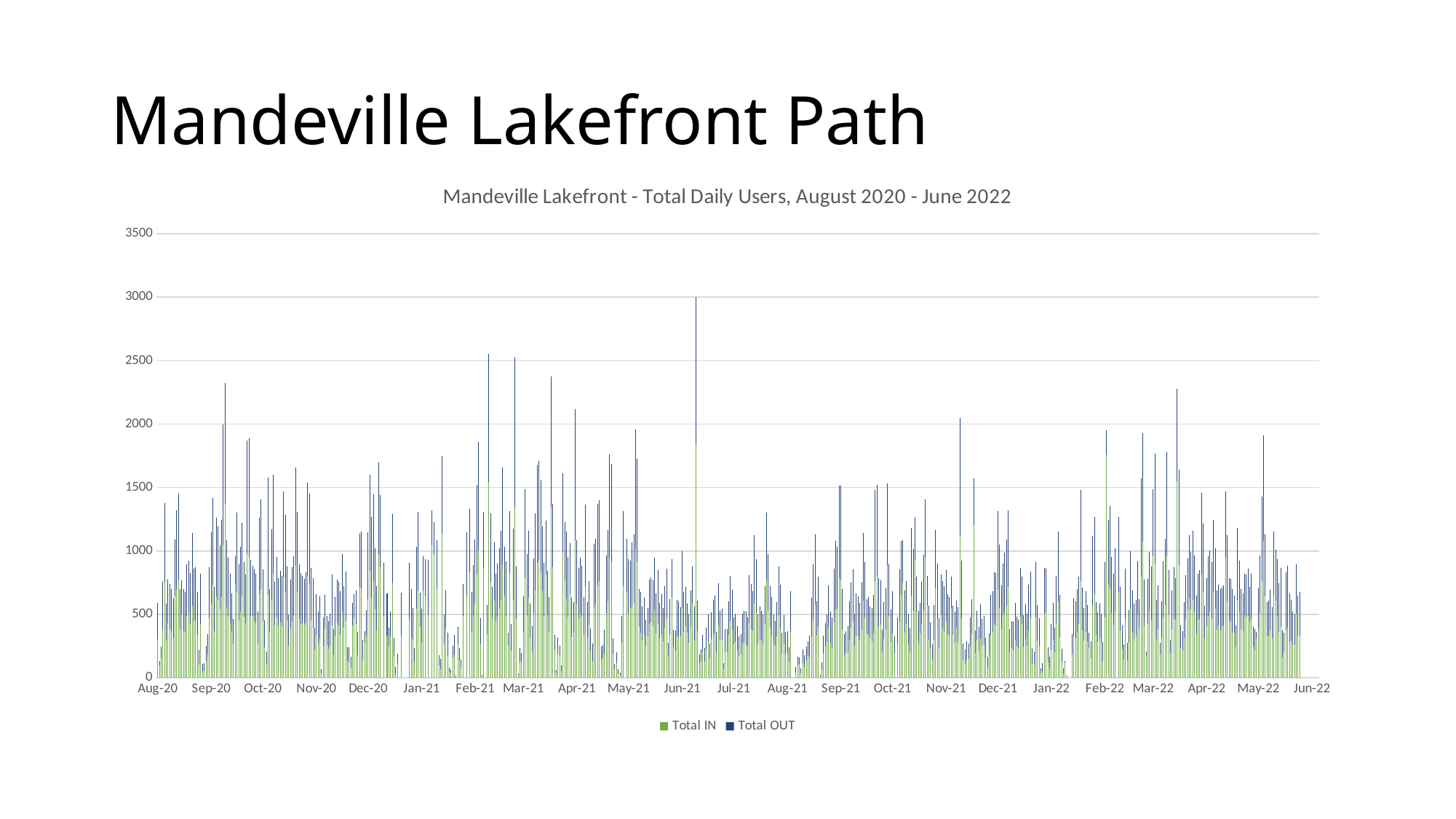
How many series does the legend list? 2 Is the tallest bar near Jul-21 greater or less than 1500? less How many month labels are shown along the x axis? 23 Which colour represents the Total IN series? green Is the highest value on the chart greater or less than 2500? greater Is the highest value on the chart greater or less than 3500? less What kind of chart is shown on the slide? bar chart Near which month label does the tallest bar on the chart appear? Jun-21 What is the title of the chart? Mandeville Lakefront - Total Daily Users, August 2020 - June 2022